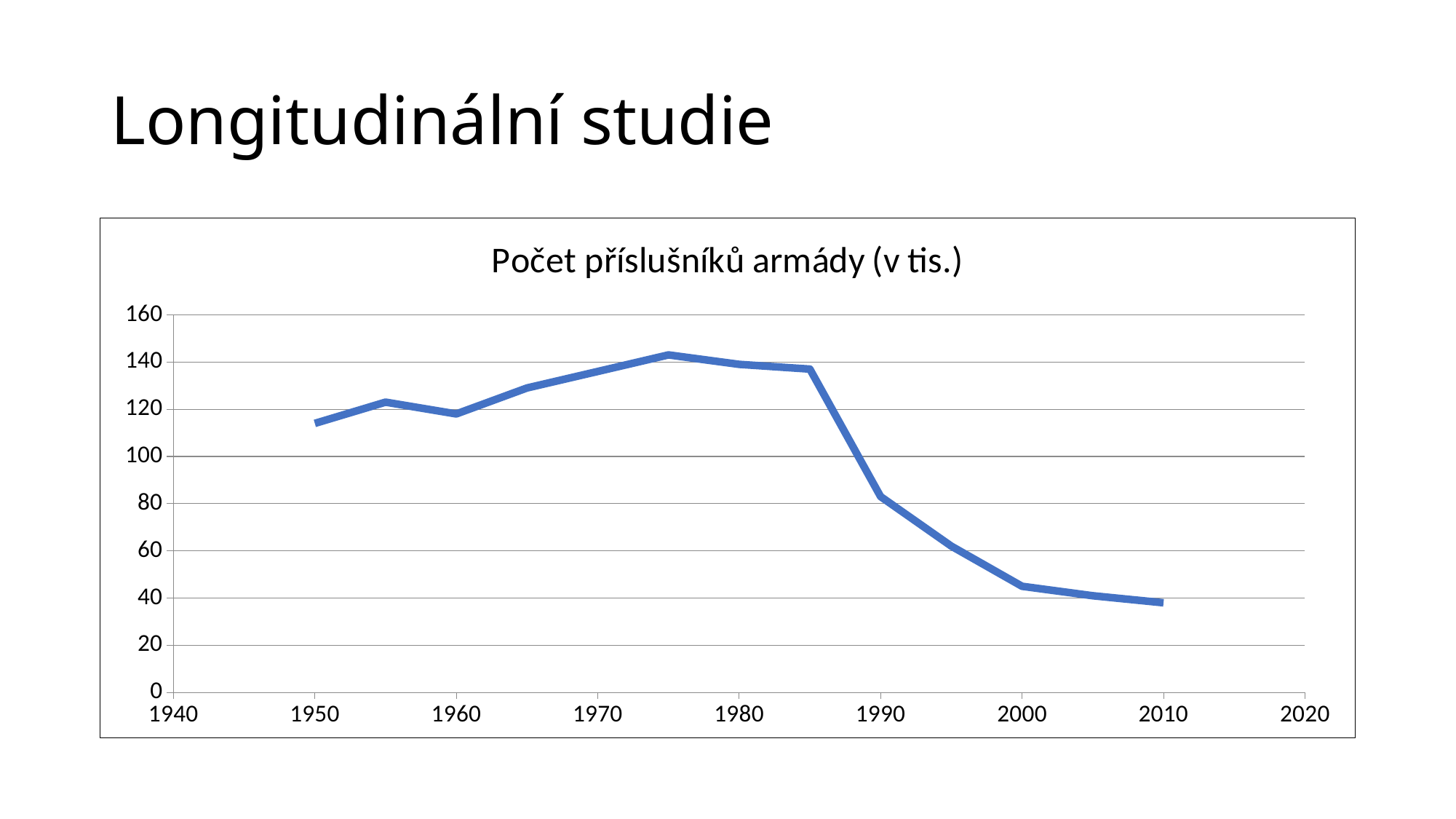
In which year does the line reach its highest value? 1975 What kind of chart is shown on the slide? line chart In which year does the line reach its lowest value? 2010 What is the title of the chart? Počet příslušníků armády (v tis.) Which year has the larger value, 1960 or 1970? 1970 Is the value for 1990 greater or less than 100? less Does the line rise or fall between 1985 and 2010? fall Is the value for 1950 greater or less than 100? greater Is the value for 1975 greater or less than 140? greater Which year has the larger value, 1950 or 1990? 1950